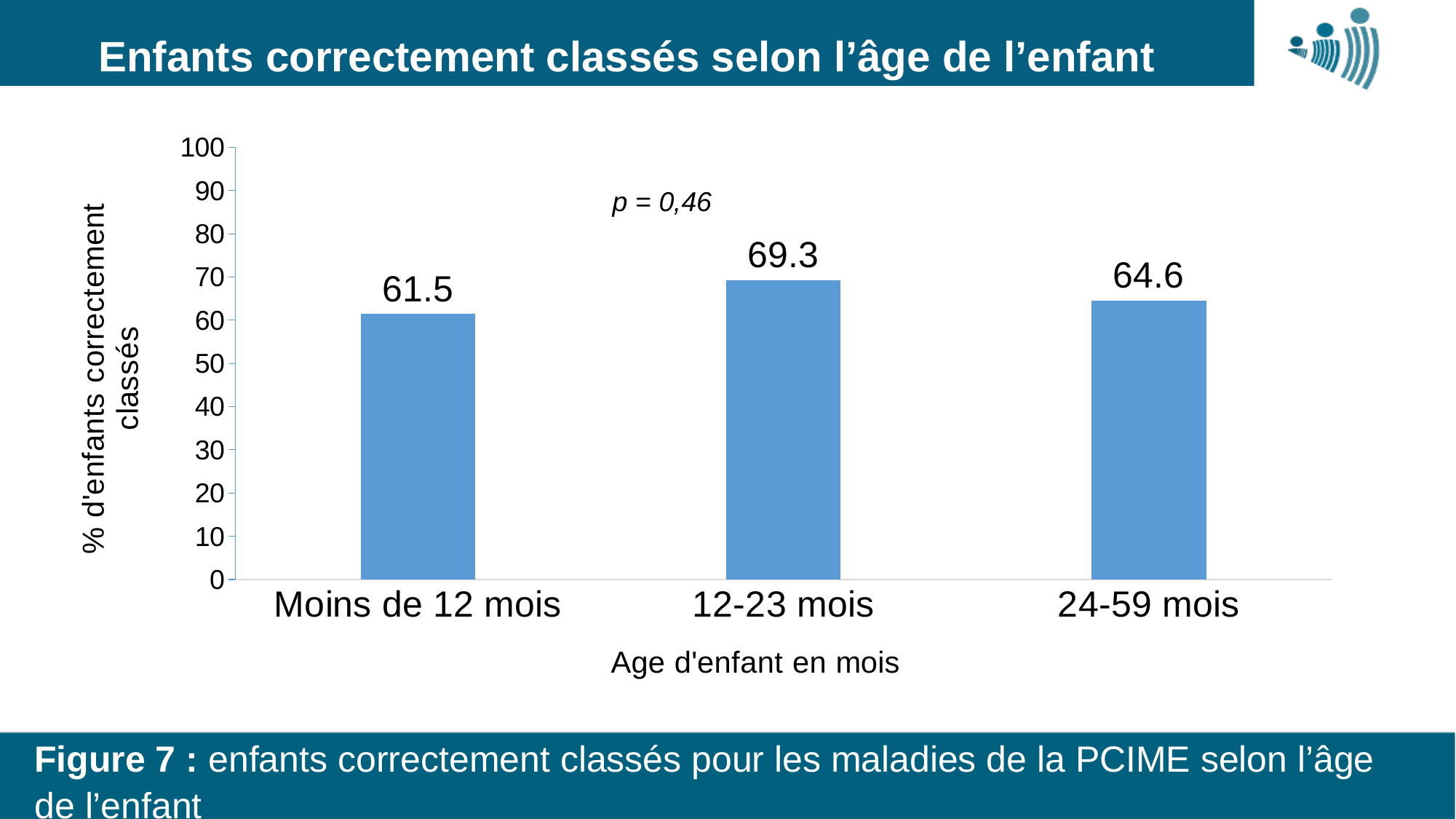
What is the value for '24-59 mois'? 64.6 What is the value for 'Moins de 12 mois'? 61.5 What is the value for '12-23 mois'? 69.3 Which is larger, the value for '24-59 mois' or the value for 'Moins de 12 mois'? 24-59 mois Is the value for '12-23 mois' greater or less than 60? greater What kind of chart is shown on the slide? bar chart What p-value is printed on the chart? p = 0,46 What is the difference between the values for '12-23 mois' and 'Moins de 12 mois'? 7.8 Which age group has the highest percentage of correctly classified children? 12-23 mois How many age groups are shown on the chart? 3 What is the difference between the values for '12-23 mois' and '24-59 mois'? 4.7 Which age group has the lowest percentage of correctly classified children? Moins de 12 mois